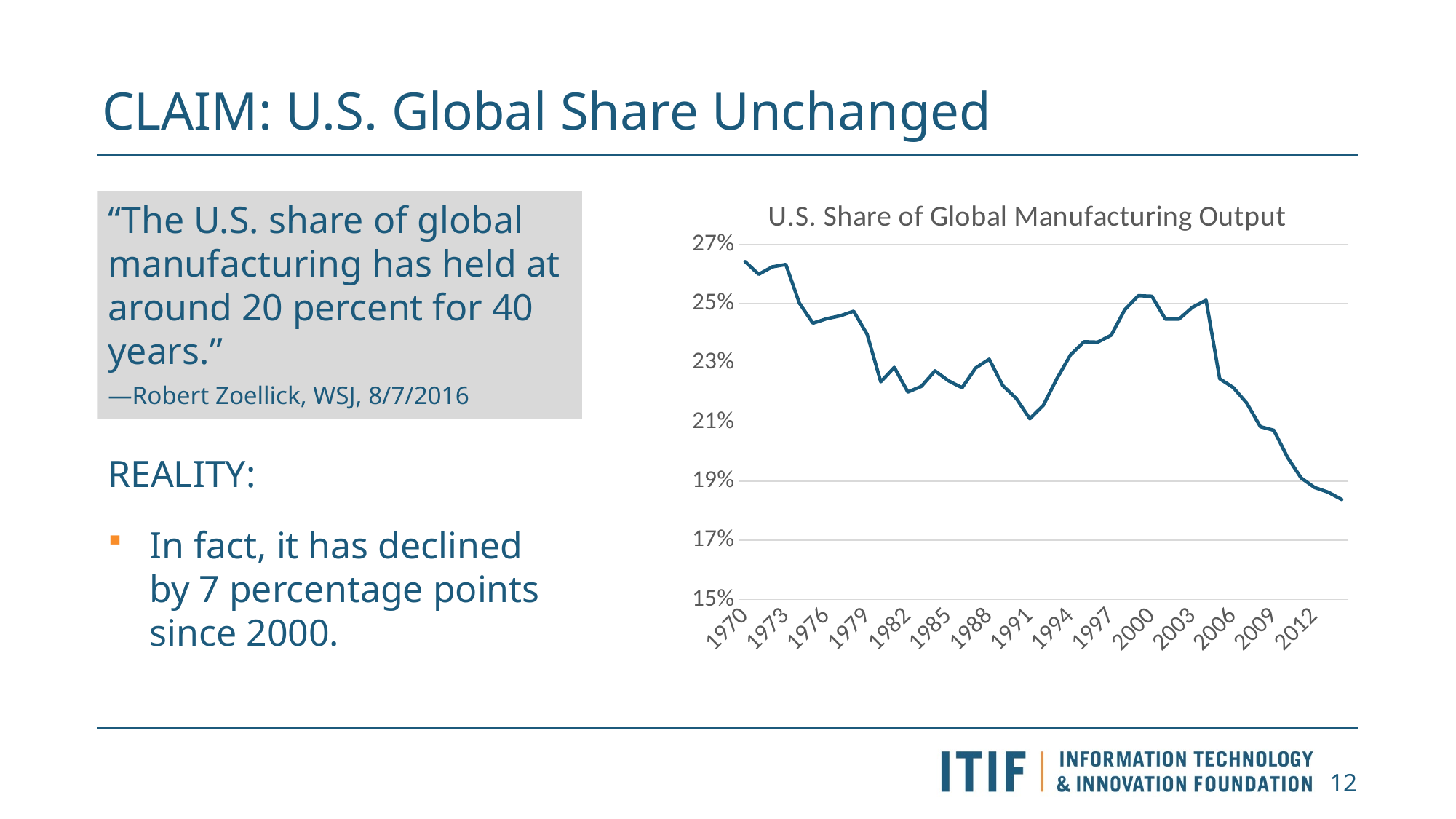
Is the value for 2006 greater or less than 23%? less Is the value for 1970 greater or less than 25%? greater Which is larger, the value for 2000 or the value for 1991? 2000 Is the value at the final point of the line (after 2012) greater or less than 19%? less What kind of chart is shown on the slide? line chart What is the title of the chart? U.S. Share of Global Manufacturing Output Which is larger, the value for 1970 or the value for 2012? 1970 How many year labels are shown on the x axis? 15 Does the U.S. share of global manufacturing output rise or fall between 2003 and the end of the series? fall